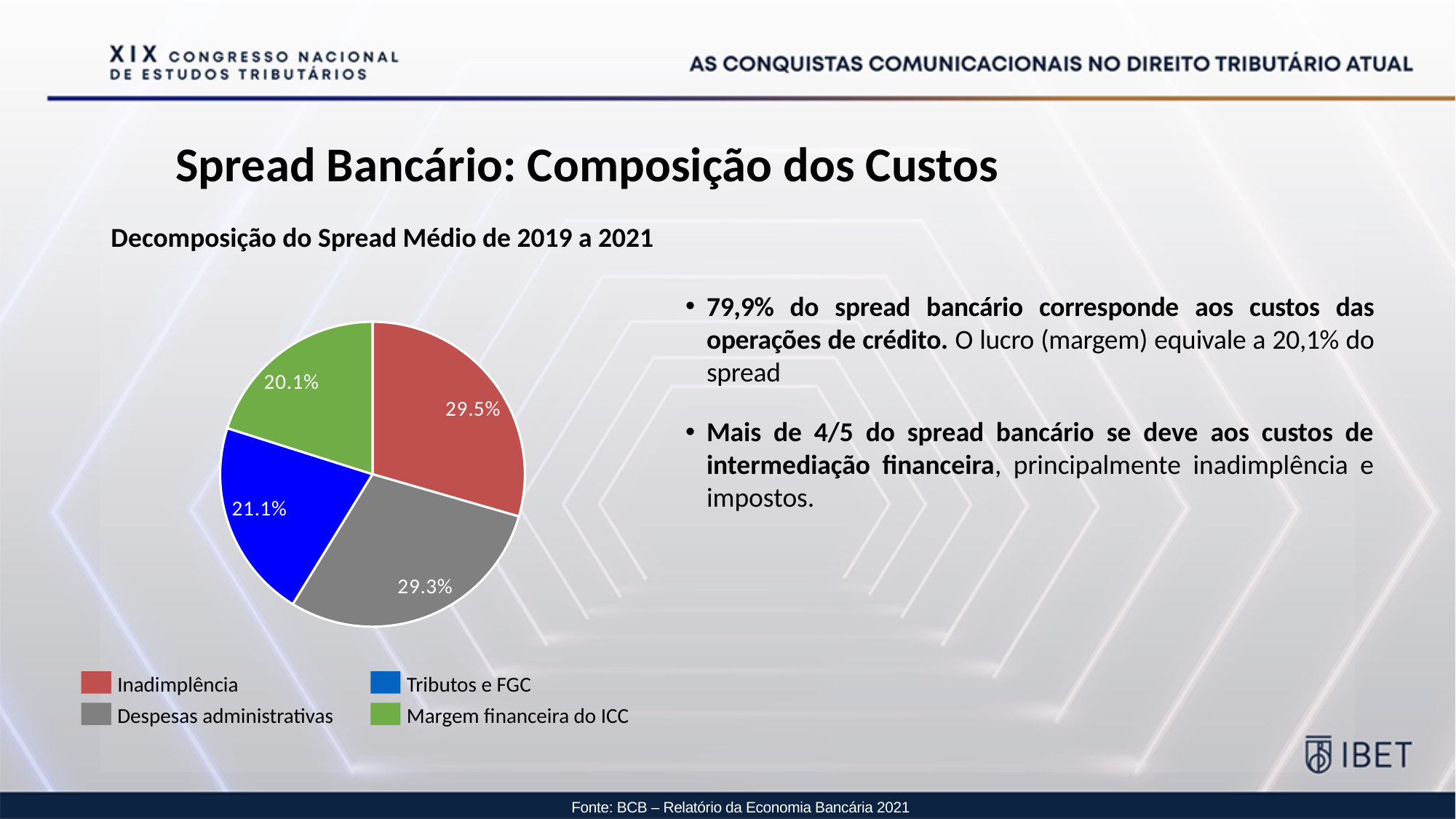
What is the value shown for Despesas administrativas? 29.3% What share of the pie does Inadimplência represent? 29.5% What is the value shown for Margem financeira do ICC? 20.1% What is the subtitle shown above the pie chart? Decomposição do Spread Médio de 2019 a 2021 What colour is the Tributos e FGC slice? Blue What is the difference between the Inadimplência and Margem financeira do ICC slices? 9.4 percentage points How many slices does the pie chart have? 4 Which category has the largest slice of the pie? Inadimplência Which category has the smallest slice of the pie? Margem financeira do ICC What is the value shown for Tributos e FGC? 21.1% Which is larger: Despesas administrativas or Tributos e FGC? Despesas administrativas What kind of chart is shown on the slide? Pie chart